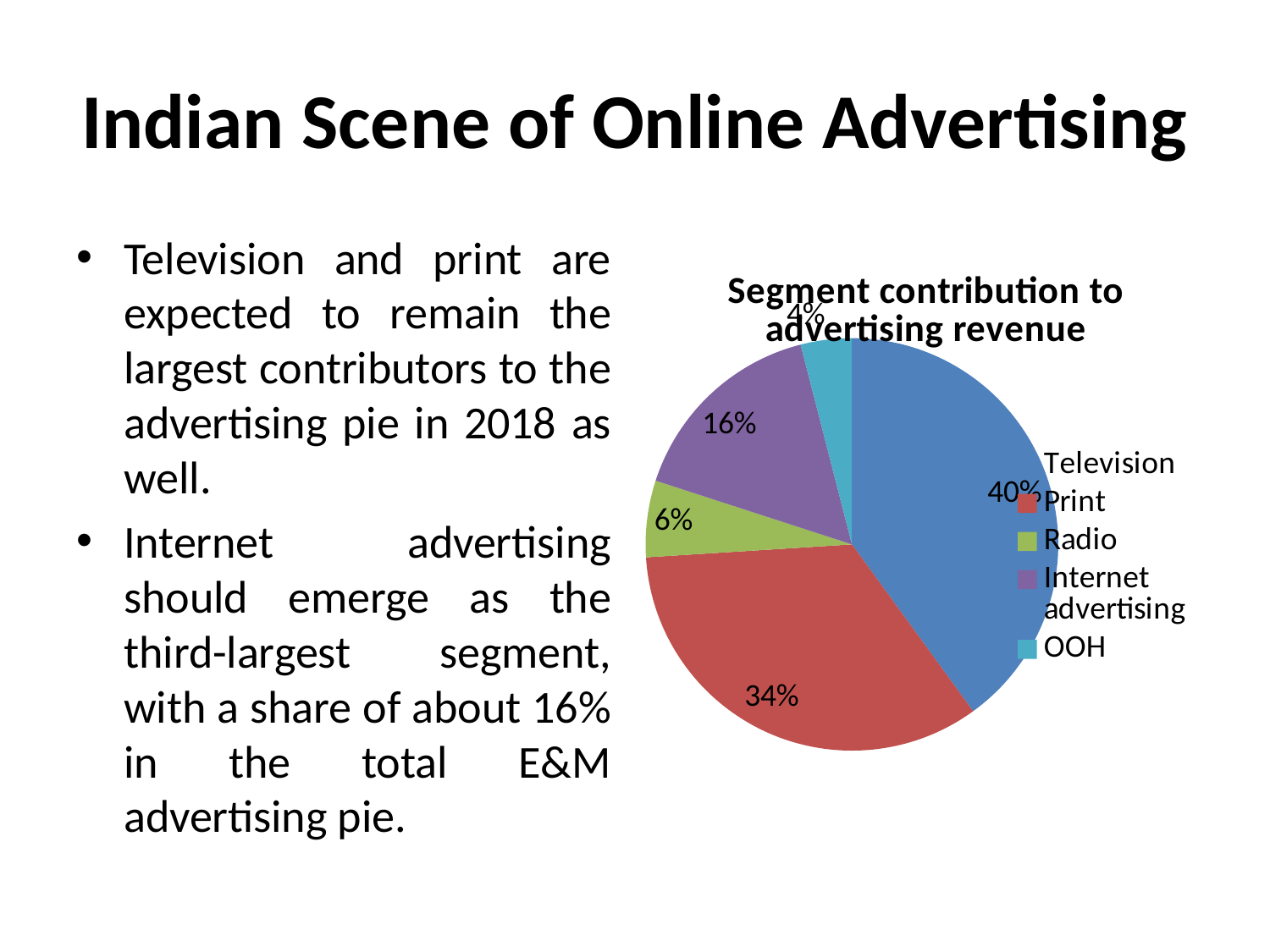
What share of advertising revenue does Radio contribute? 6% How many segments are shown in the pie chart? 5 What share of advertising revenue does Internet advertising contribute? 16% What is the difference between the Television and Print shares? 6% What type of chart is shown on the slide? pie chart What share of advertising revenue does Print contribute? 34% What share of advertising revenue does Television contribute? 40% What is the title of the chart? Segment contribution to advertising revenue Which has a larger share, Internet advertising or Radio? Internet advertising What share of advertising revenue does OOH contribute? 4% Which segment has the smallest share of advertising revenue? OOH Which segment has the largest share of advertising revenue? Television